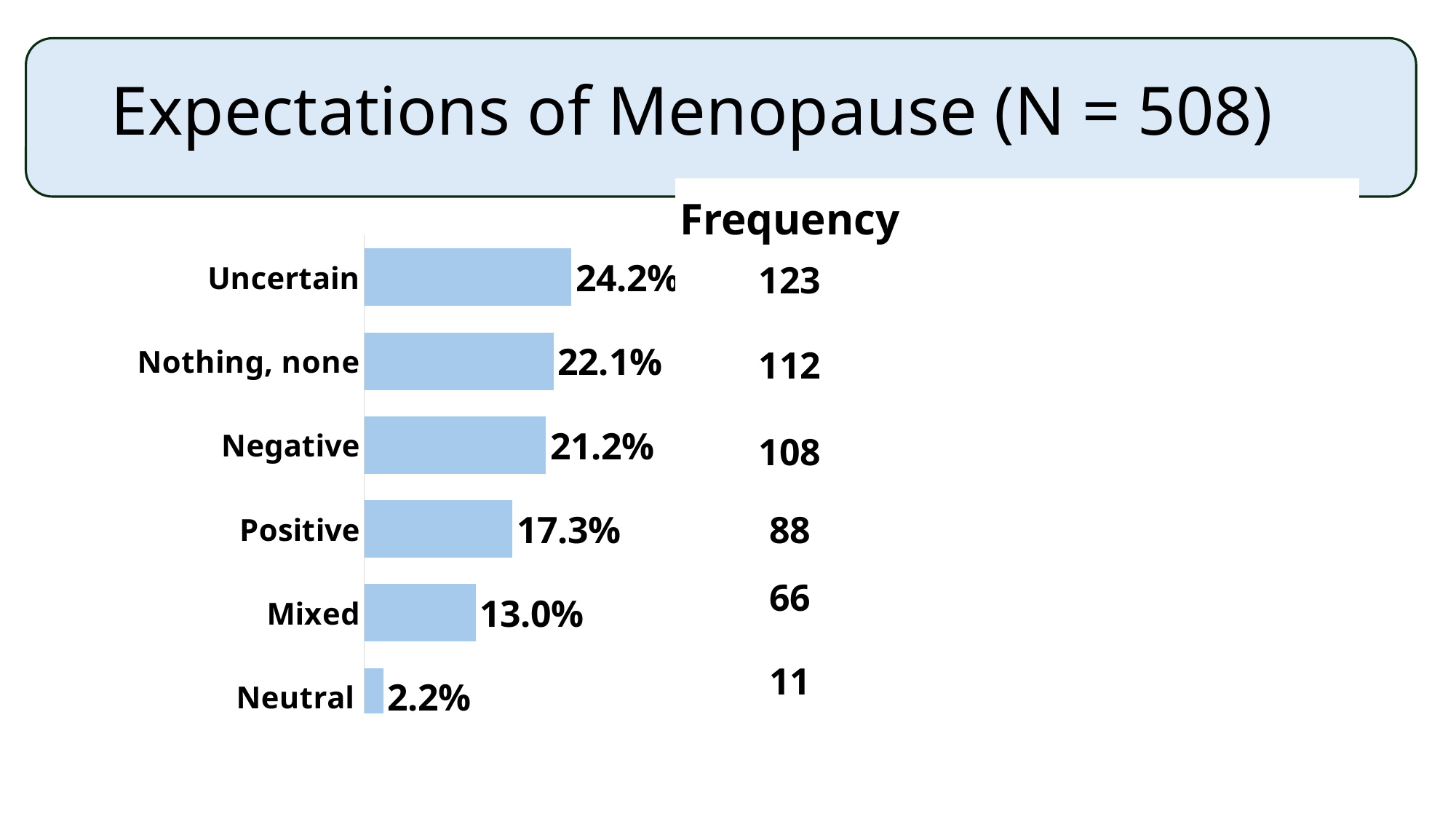
How many categories are shown in the bar chart? 6 What kind of chart is shown on the slide? Bar chart What is the difference in percentage points between Mixed and Neutral? 10.8 Which category has the lowest percentage? Neutral What percentage is shown for the Uncertain category? 24.2% What percentage is shown for the Mixed category? 13.0% What percentage is shown for the Negative category? 21.2% What is the frequency listed next to the Positive category? 88 Which category has the highest percentage? Uncertain What is the difference in percentage points between Uncertain and Positive? 6.9 Which has a larger percentage, Nothing, none or Positive? Nothing, none What is the title of the slide? Expectations of Menopause (N = 508)